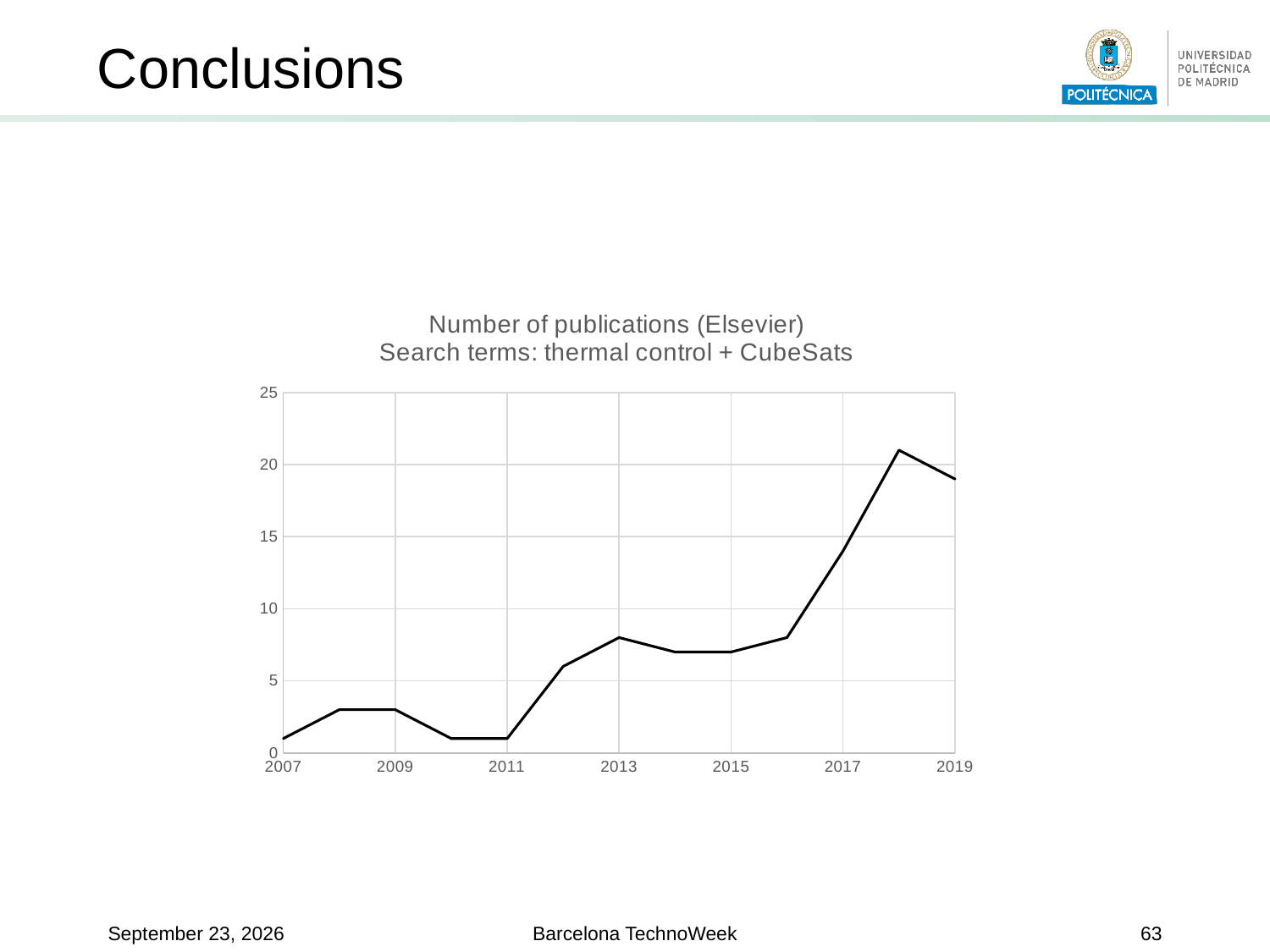
Is the value for 2013 greater or less than 10? less Which year has more publications, 2013 or 2017? 2017 Is the value for 2017 greater or less than 10? greater Is the value for 2018 greater or less than 20? greater What is the title of the chart? Number of publications (Elsevier) Search terms: thermal control + CubeSats In which year is the number of publications highest? 2018 What is the highest value shown on the y axis? 25 Which year has more publications, 2018 or 2019? 2018 What kind of chart is shown on the slide? line chart Does the number of publications generally rise or fall from 2007 to 2019? rise